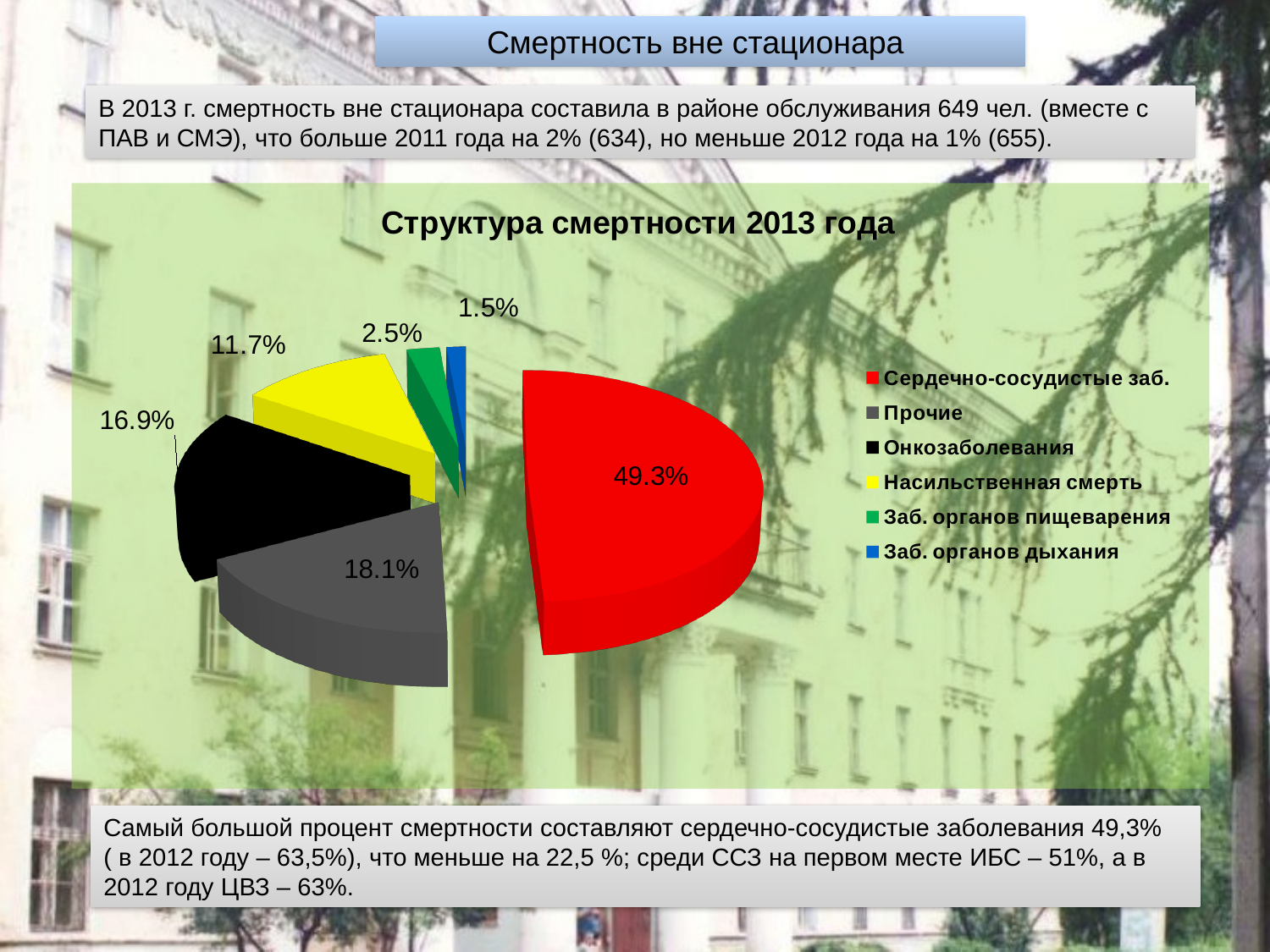
What percentage is shown for Онкозаболевания? 16.9% What percentage is shown for Насильственная смерть? 11.7% What percentage is shown for Прочие? 18.1% Which category has the largest slice of the pie? Сердечно-сосудистые заб. Which category has the smallest slice of the pie? Заб. органов дыхания What is the difference in percentage points between Прочие and Онкозаболевания? 1.2 What is the title of the chart? Структура смертности 2013 года What share of the pie is labelled for Сердечно-сосудистые заб.? 49.3% What type of chart is shown on the slide? Pie chart What percentage is shown for Заб. органов дыхания? 1.5% Which is larger, the slice for Заб. органов пищеварения or the slice for Заб. органов дыхания? Заб. органов пищеварения How many categories does the legend list? 6